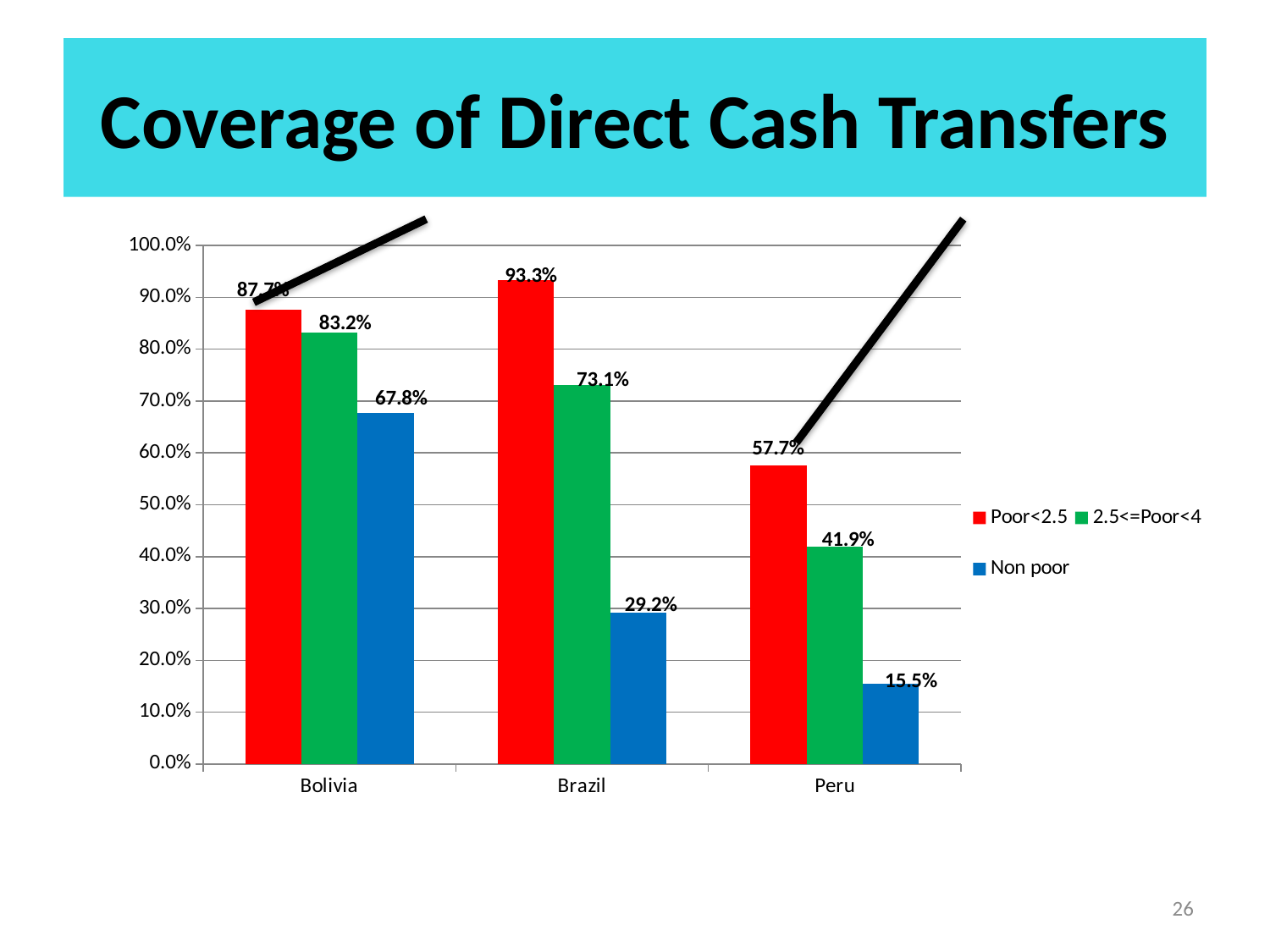
What is the value for Non poor in Brazil? 29.2% What type of chart is shown on the slide? bar chart How many series does the legend list? 3 What is the value for 2.5<=Poor<4 in Peru? 41.9% Which country has the highest value for Poor<2.5? Brazil Which country has the lowest value for Non poor? Peru Does the Non poor value fall or rise from Bolivia to Peru? fall What is the difference between the 2.5<=Poor<4 value and the Non poor value in Brazil? 43.9% What is the value for Poor<2.5 in Brazil? 93.3% How many countries are shown on the x axis? 3 What is the value for Non poor in Bolivia? 67.8% Which is larger: the 2.5<=Poor<4 value in Bolivia or the 2.5<=Poor<4 value in Brazil? Bolivia